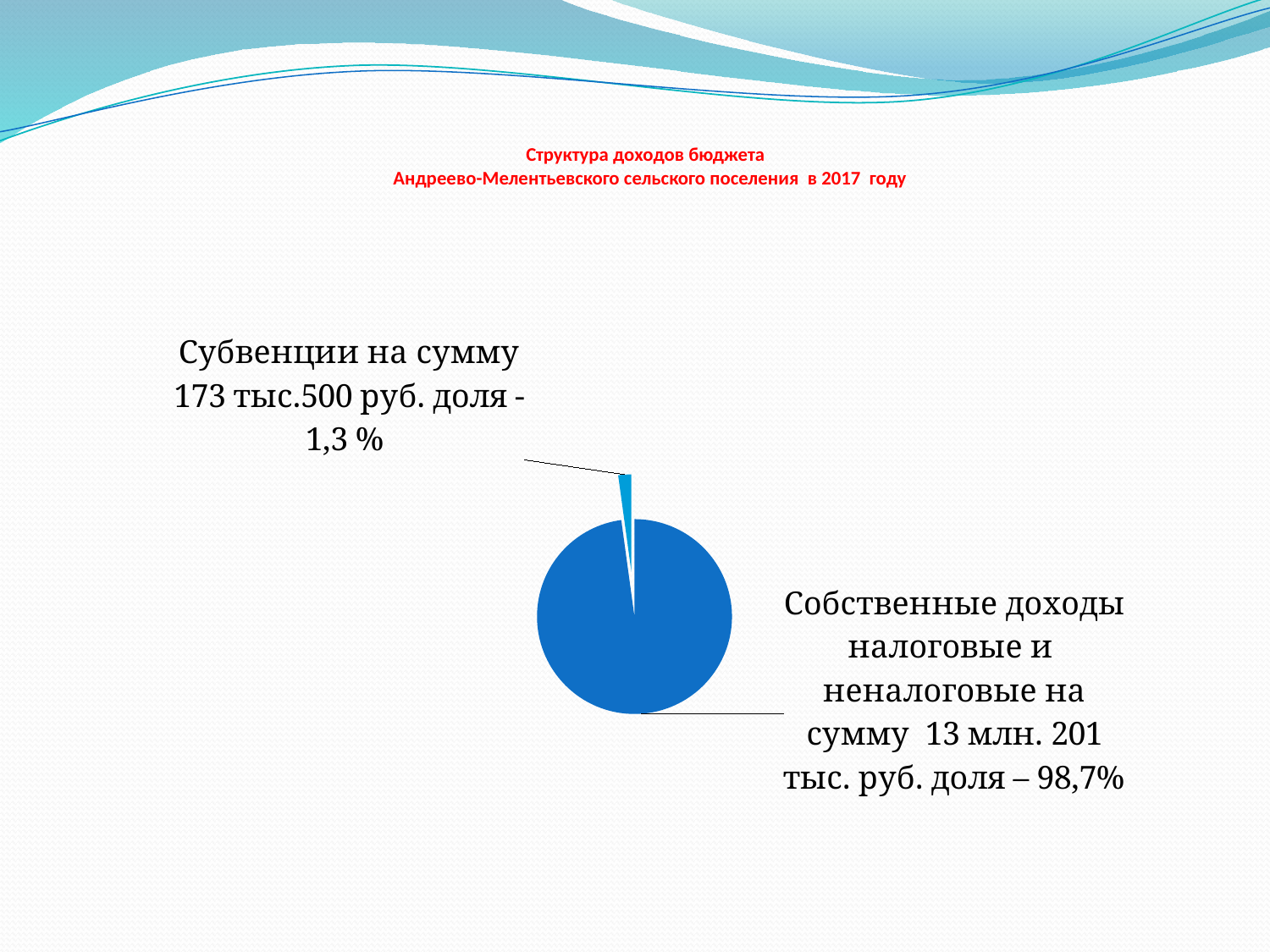
What share of the pie does the 'Собственные доходы налоговые и неналоговые' slice represent? 98,7% How many slices does the pie chart have? 2 Which year does the chart on the slide refer to? 2017 What kind of chart is shown on the slide? pie chart Which is larger: the share of 'Субвенции' or the share of 'Собственные доходы налоговые и неналоговые'? Собственные доходы налоговые и неналоговые What share of the pie does the 'Субвенции' slice represent? 1,3 % What is the amount of 'Субвенции' shown on the slide? 173 тыс.500 руб. What is the amount of 'Собственные доходы налоговые и неналоговые' shown on the slide? 13 млн. 201 тыс. руб. What is the difference in percentage points between the share of 'Собственные доходы' and the share of 'Субвенции'? 97,4 Which slice of the pie is the largest? Собственные доходы налоговые и неналоговые What is the title of the chart on the slide? Структура доходов бюджета Андреево-Мелентьевского сельского поселения в 2017 году Which slice of the pie is the smallest? Субвенции